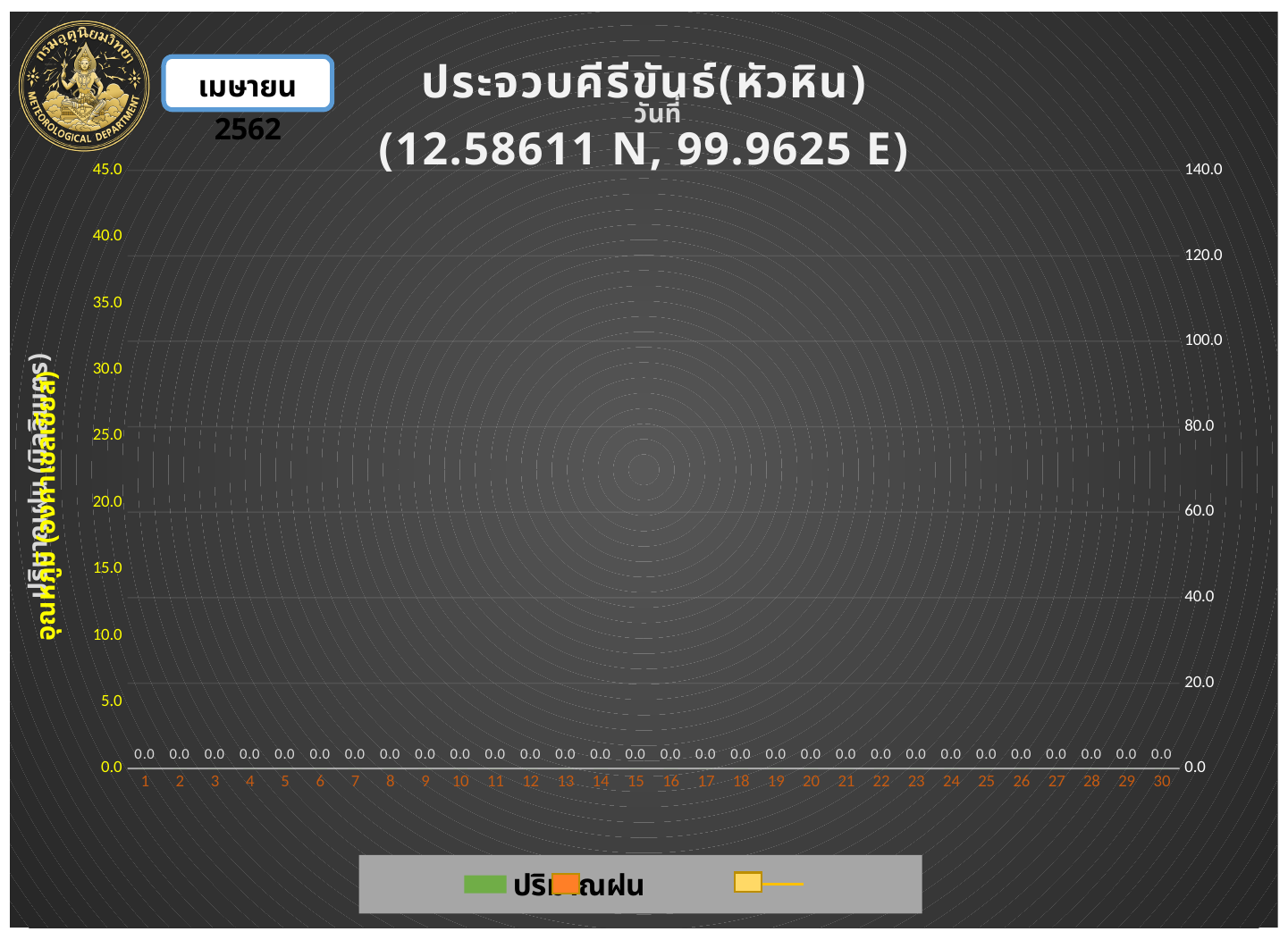
What is the first day number shown on the x axis? 1 What is the last day number shown on the x axis? 30 What is the highest tick value on the left vertical axis? 45.0 What is the highest tick value on the right vertical axis? 140.0 Is the value for day 25 greater or less than 20.0 on the right axis? less What is the difference between the values labelled for day 10 and day 20? 0.0 Is the value for day 5 greater or less than 5.0 on the left axis? less What is the data label shown for day 30? 0.0 What is the data label shown for day 15? 0.0 What is the data label shown for day 1? 0.0 Do the labelled values rise, fall, or stay the same from day 1 to day 30? stay the same How many days are shown along the x axis? 30